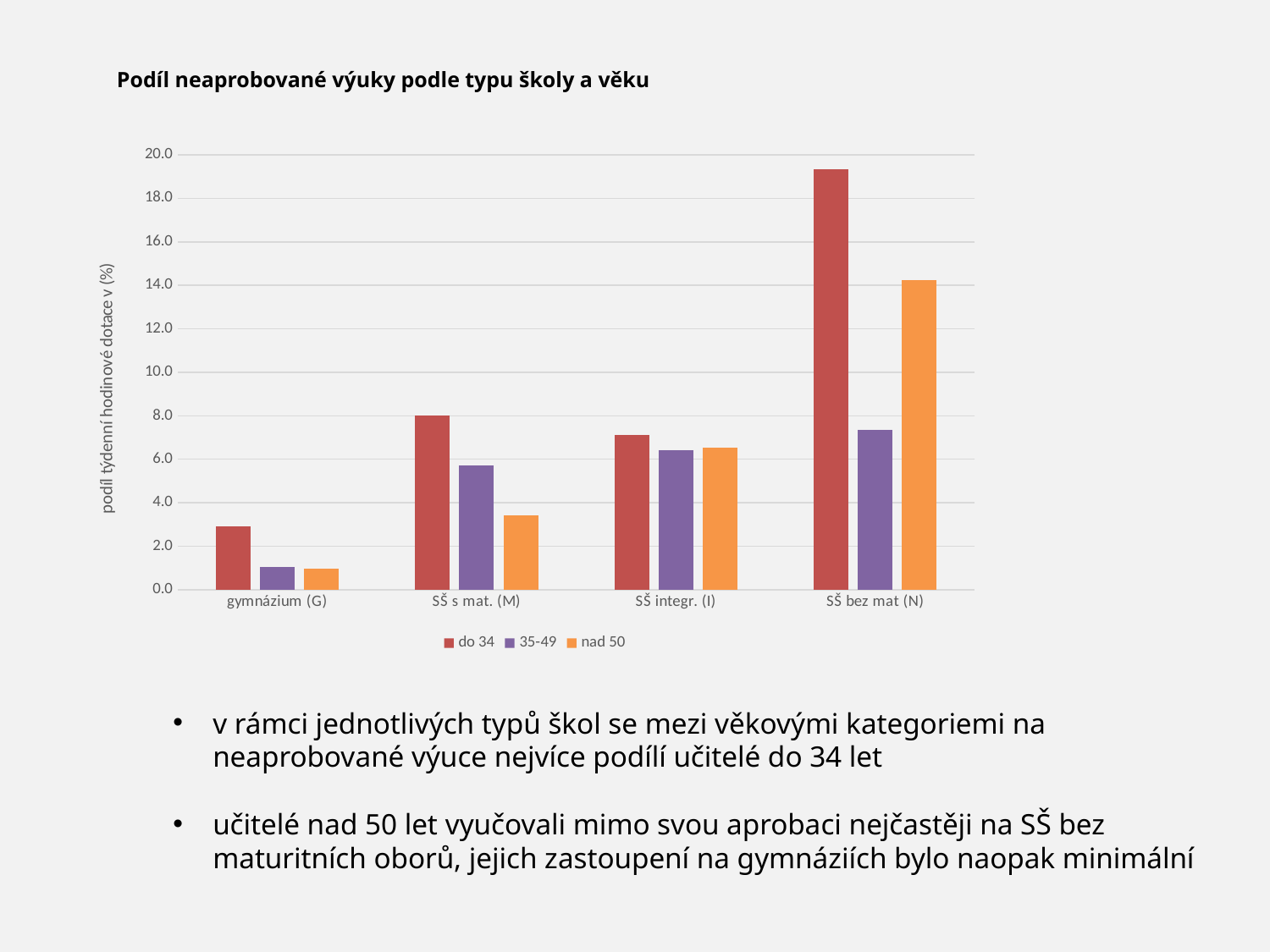
What kind of chart is shown on the slide? bar chart Which school type has the lowest value for the 'do 34' series? gymnázium (G) Is the 'do 34' value for SŠ bez mat (N) greater or less than 18.0? greater Is the 'nad 50' value for gymnázium (G) greater or less than 2.0? less Which school type has the highest value for the 'do 34' series? SŠ bez mat (N) Which is larger: the 'do 34' value for SŠ s mat. (M) or for SŠ integr. (I)? SŠ s mat. (M) For SŠ bez mat (N), which is larger: the '35-49' value or the 'nad 50' value? nad 50 What are the three series listed in the legend? do 34, 35-49, nad 50 How many series does the legend list? 3 Is the '35-49' value for SŠ s mat. (M) greater or less than 6.0? less How many school-type categories are shown on the x axis? 4